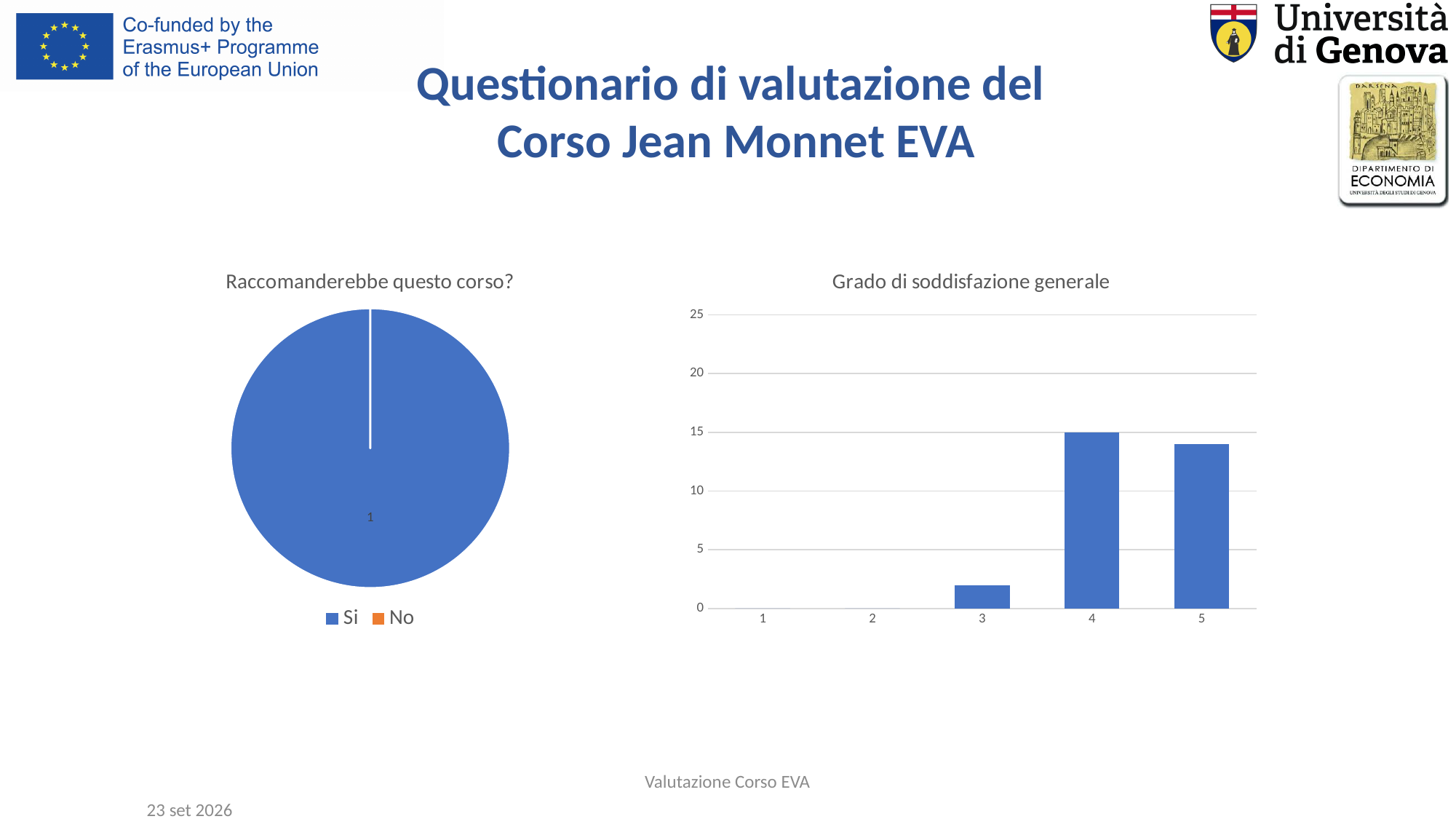
What kind of chart is the chart titled "Raccomanderebbe questo corso?"? pie chart In the chart "Grado di soddisfazione generale", which has the larger value, category 3 or category 4? 4 In the chart "Grado di soddisfazione generale", what is the value for category 4? 15 In the chart "Raccomanderebbe questo corso?", which legend entry fills the whole pie? Si What kind of chart is the chart titled "Grado di soddisfazione generale"? bar chart How many entries does the legend of the chart "Raccomanderebbe questo corso?" list? 2 In the chart "Grado di soddisfazione generale", which category has the highest value? 4 In the chart "Grado di soddisfazione generale", how many categories are shown on the x axis? 5 In the chart "Grado di soddisfazione generale", do the values rise or fall from category 1 to category 4? rise In the chart "Grado di soddisfazione generale", is the value for category 3 greater or less than 5? less In the chart "Grado di soddisfazione generale", is the value for category 5 greater or less than 10? greater What are the legend entries of the chart "Raccomanderebbe questo corso?"? Si, No